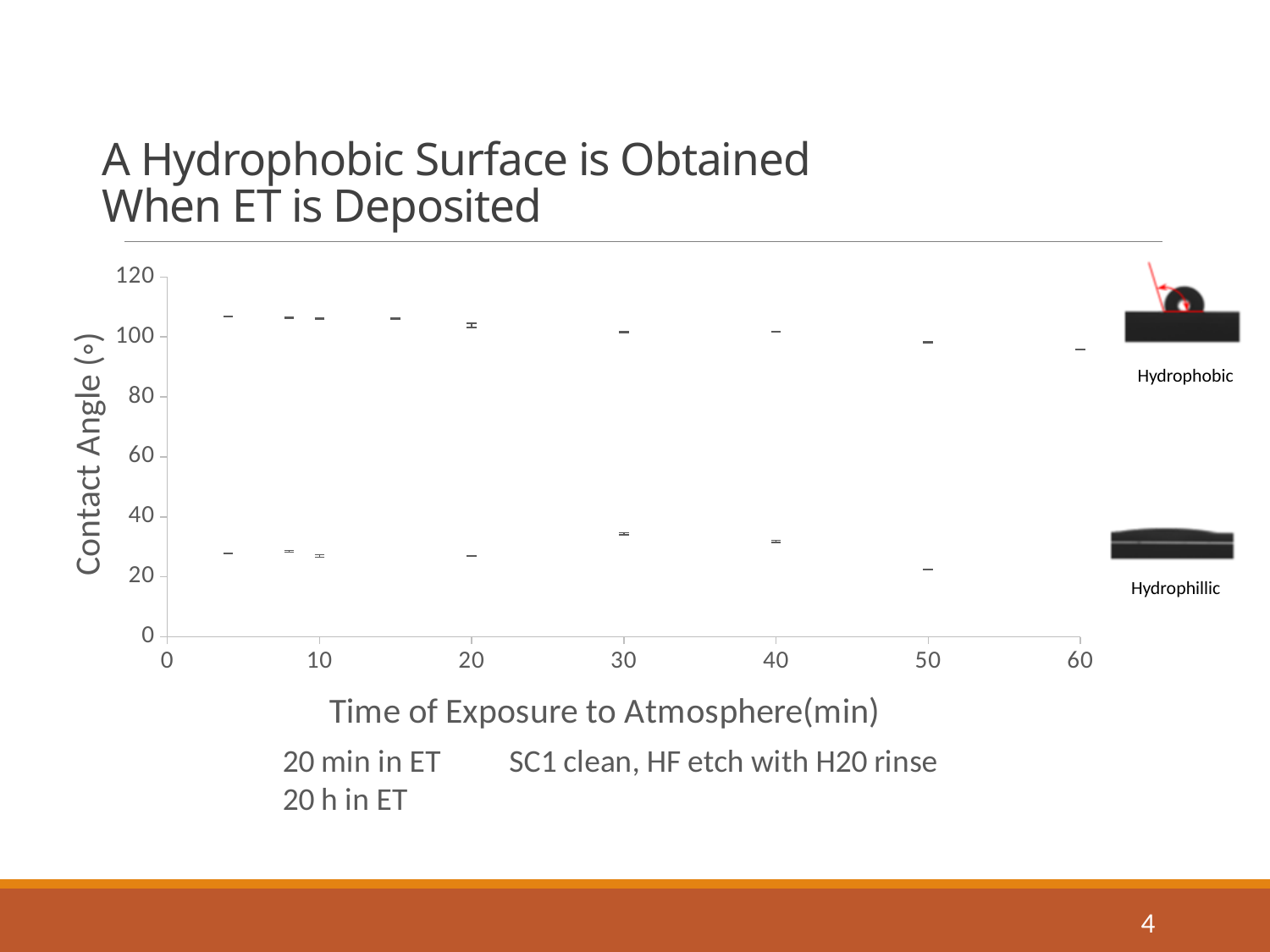
Is the contact angle of the upper group of points at 10 min greater or less than 100? greater How many tick labels are shown on the x axis of the chart? 7 Does the contact angle of the upper group of points rise or fall as time of exposure increases from 0 to 60 min? fall What is the label of the x axis of the chart? Time of Exposure to Atmosphere(min) What is the highest tick value shown on the y axis of the chart? 120 For the upper group of points, is the contact angle at 10 min larger or smaller than at 60 min? larger Is the contact angle of the lower group of points at 50 min greater or less than 40? less What type of chart is shown on the slide? scatter chart How many entries does the chart's legend list? 3 What is the title of the chart on the slide? A Hydrophobic Surface is Obtained When ET is Deposited Is the contact angle of the lower group of points at 30 min greater or less than 60? less